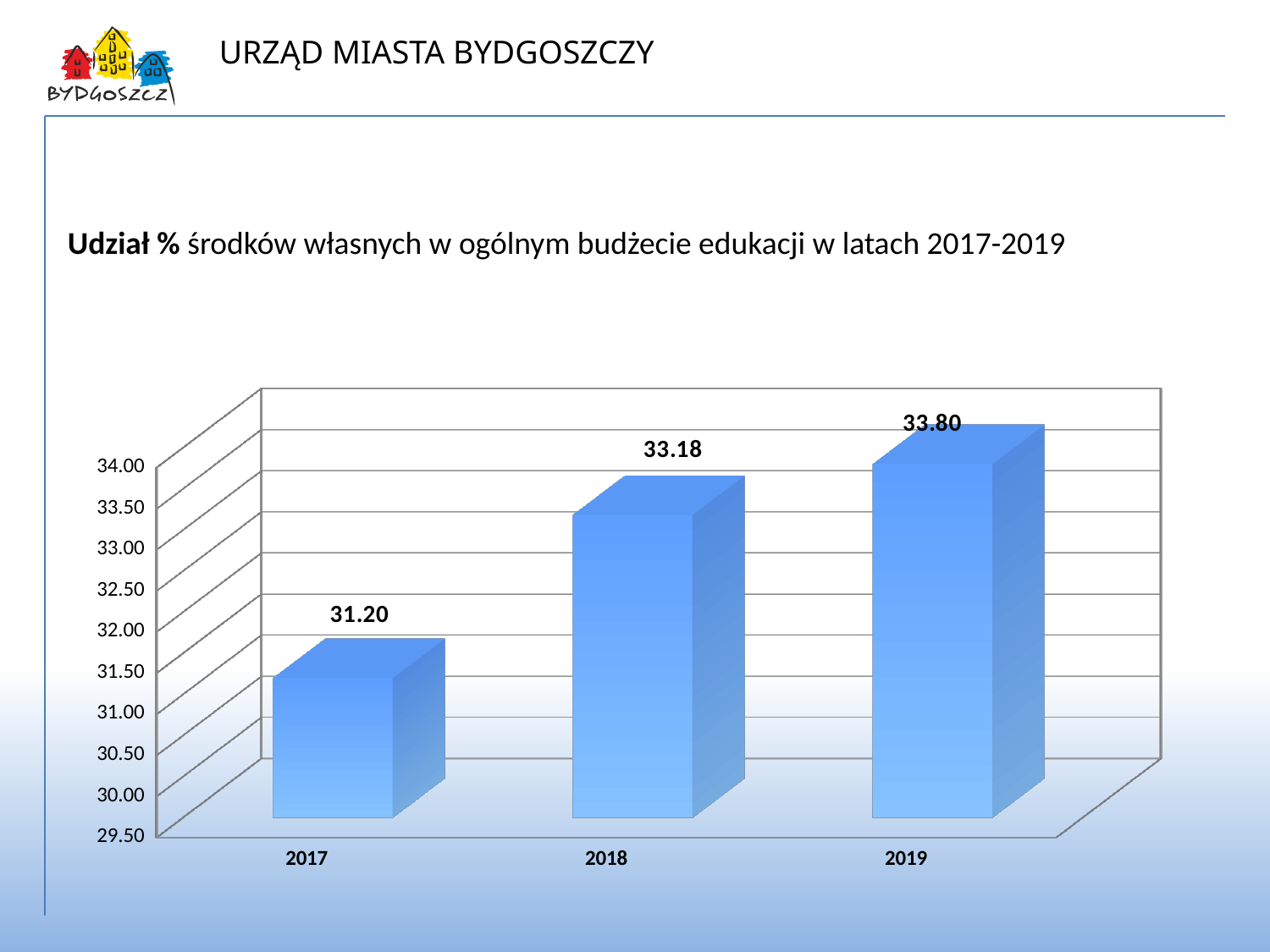
What is the difference between the values for 2019 and 2018? 0.62 What kind of chart is shown on the slide? bar chart What is the value for 2017? 31.20 Is the value for 2017 greater or less than 32.00? less What is the value for 2018? 33.18 What is the value for 2019? 33.80 What is the difference between the values for 2019 and 2017? 2.60 Which year has the highest value? 2019 Do the values rise or fall from 2017 to 2019? rise Which is larger, the value for 2018 or the value for 2017? 2018 How many years are shown on the chart? 3 Which year has the lowest value? 2017